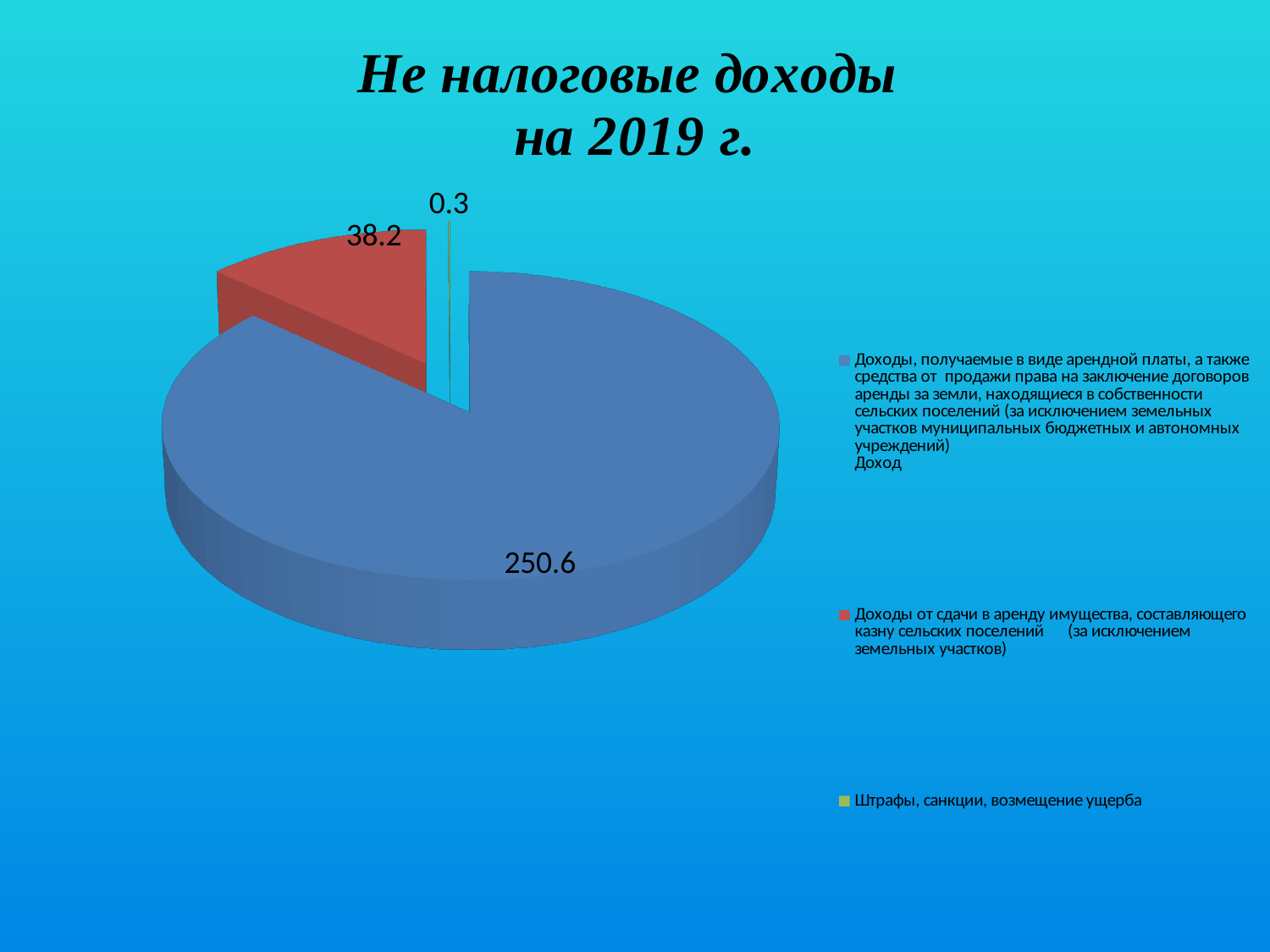
How many entries does the legend list? 3 What is the value for "Доходы от сдачи в аренду имущества, составляющего казну сельских поселений (за исключением земельных участков)"? 38.2 Which is larger: the value for "Доходы от сдачи в аренду имущества" or the value for "Штрафы, санкции, возмещение ущерба"? Доходы от сдачи в аренду имущества What is the title of the chart on the slide? Не налоговые доходы на 2019 г. How many slices does the pie chart have? 3 What colour is the slice for "Штрафы, санкции, возмещение ущерба" in the legend? Yellow-green What kind of chart is shown on the slide? Pie chart Which category has the smallest slice of the pie? Штрафы, санкции, возмещение ущерба Which category has the largest slice of the pie? Доходы, получаемые в виде арендной платы, а также средства от продажи права на заключение договоров аренды за земли What is the difference between the value 250.6 and the value 38.2? 212.4 What is the value for "Штрафы, санкции, возмещение ущерба"? 0.3 What is the value of the largest slice, "Доходы, получаемые в виде арендной платы..."? 250.6